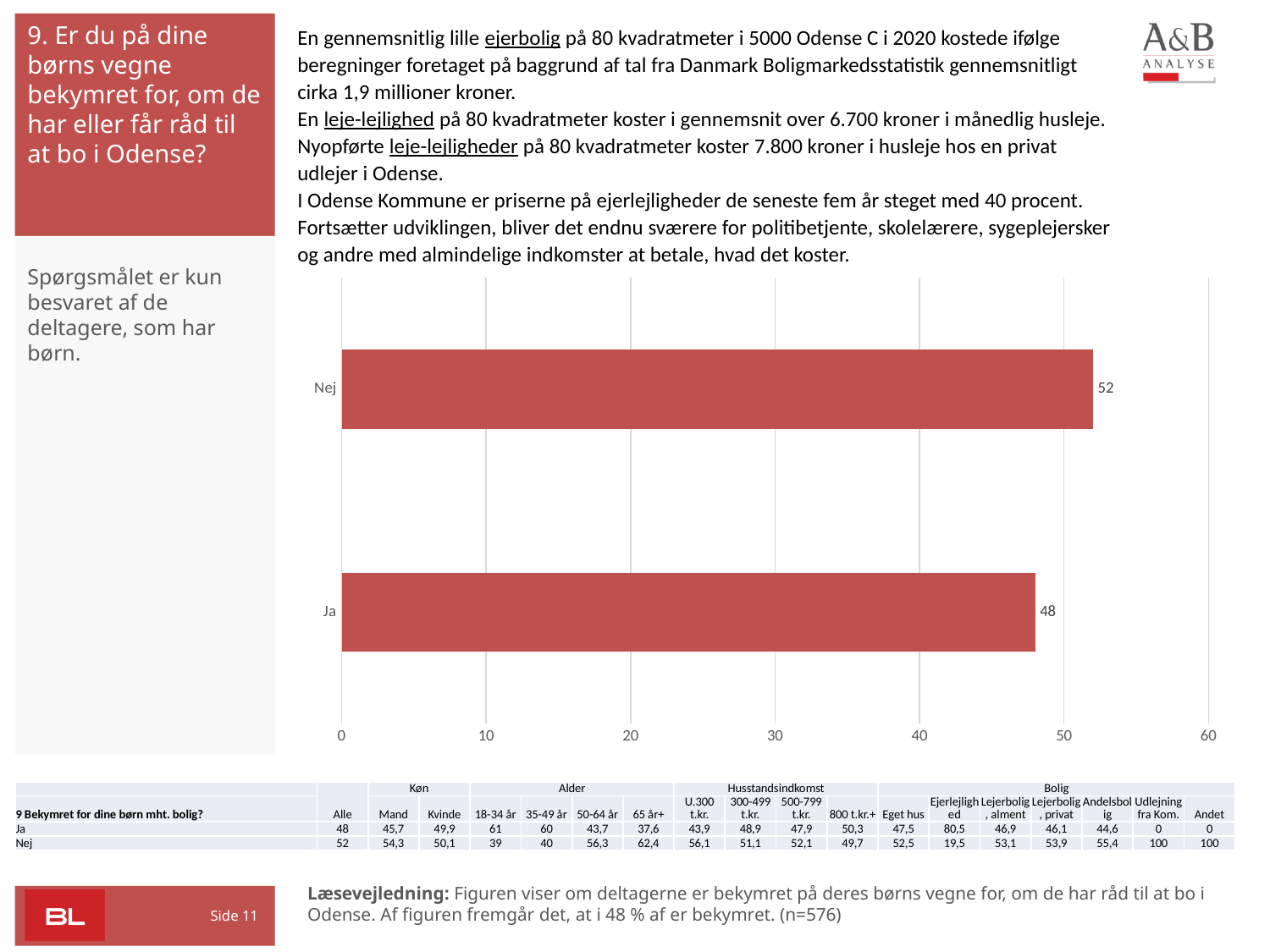
Is the value for Nej greater or less than 50? greater What kind of chart is shown on the slide? bar chart Which category has the highest value? Nej What colour are the bars in the chart? red Is the value for Ja greater or less than 50? less Which is larger, the value for Ja or the value for Nej? Nej What is the maximum value shown on the x axis? 60 What is the difference between the values for Nej and Ja? 4 Which category has the lowest value? Ja How many categories are shown in the chart? 2 What is the value for Ja? 48 What is the value for Nej? 52